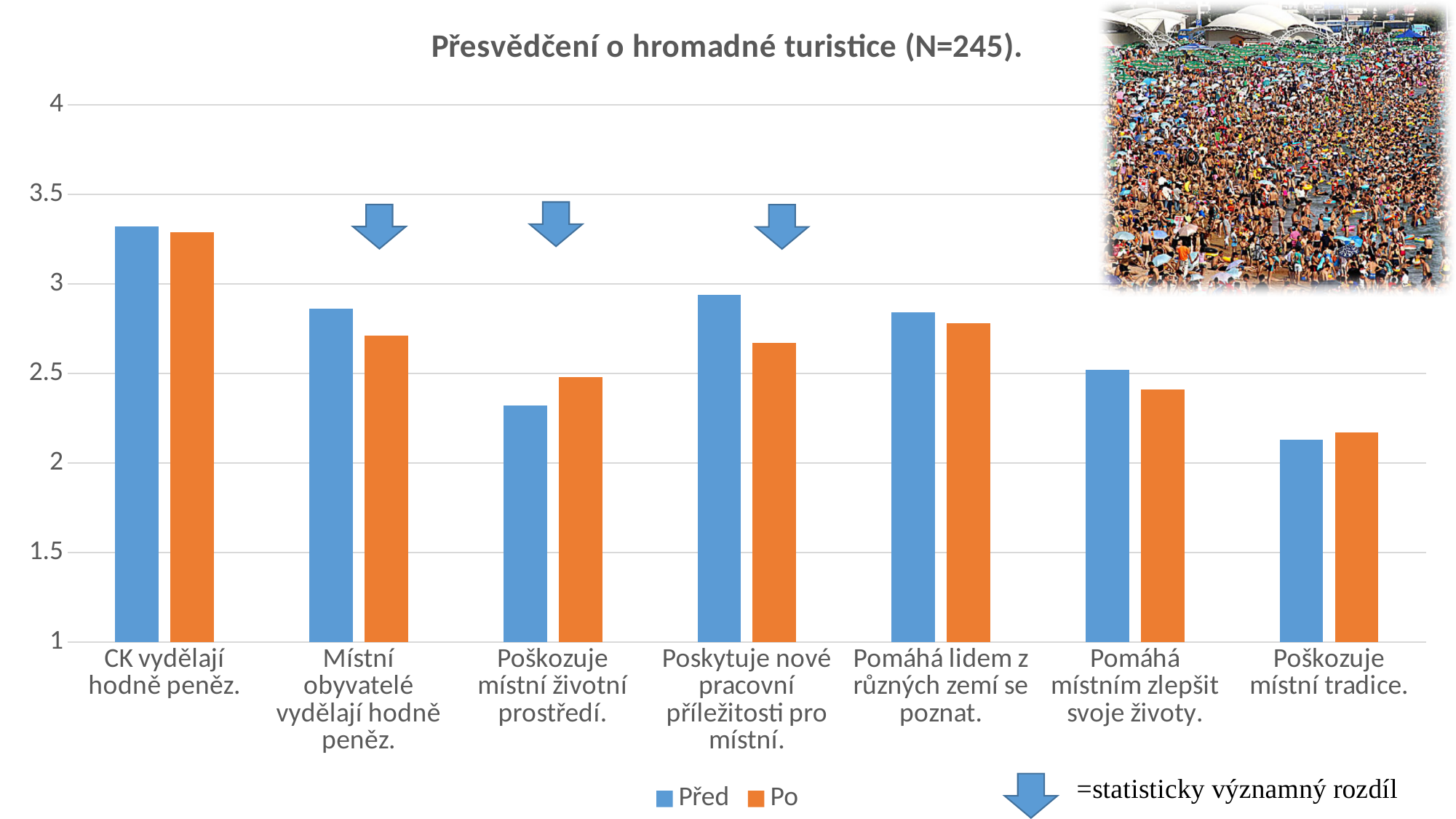
What is the title of the chart? Přesvědčení o hromadné turistice (N=245). For 'Poskytuje nové pracovní příležitosti pro místní.', which is larger, the Před value or the Po value? Před How many categories (statements) are shown on the x axis of the chart? 7 Is the Po value for 'Místní obyvatelé vydělají hodně peněz.' greater or less than 2.5? greater What are the two series named in the legend? Před and Po For 'Poškozuje místní životní prostředí.', which is larger, the Před value or the Po value? Po Is the Po value for 'Pomáhá místním zlepšit svoje životy.' greater or less than 2.5? less What kind of chart is shown on the slide? bar chart How many series does the chart's legend list? 2 Which category has the highest Před value? CK vydělají hodně peněz. Which category has the lowest Po value? Poškozuje místní tradice. Is the Před value for 'CK vydělají hodně peněz.' greater or less than 3? greater